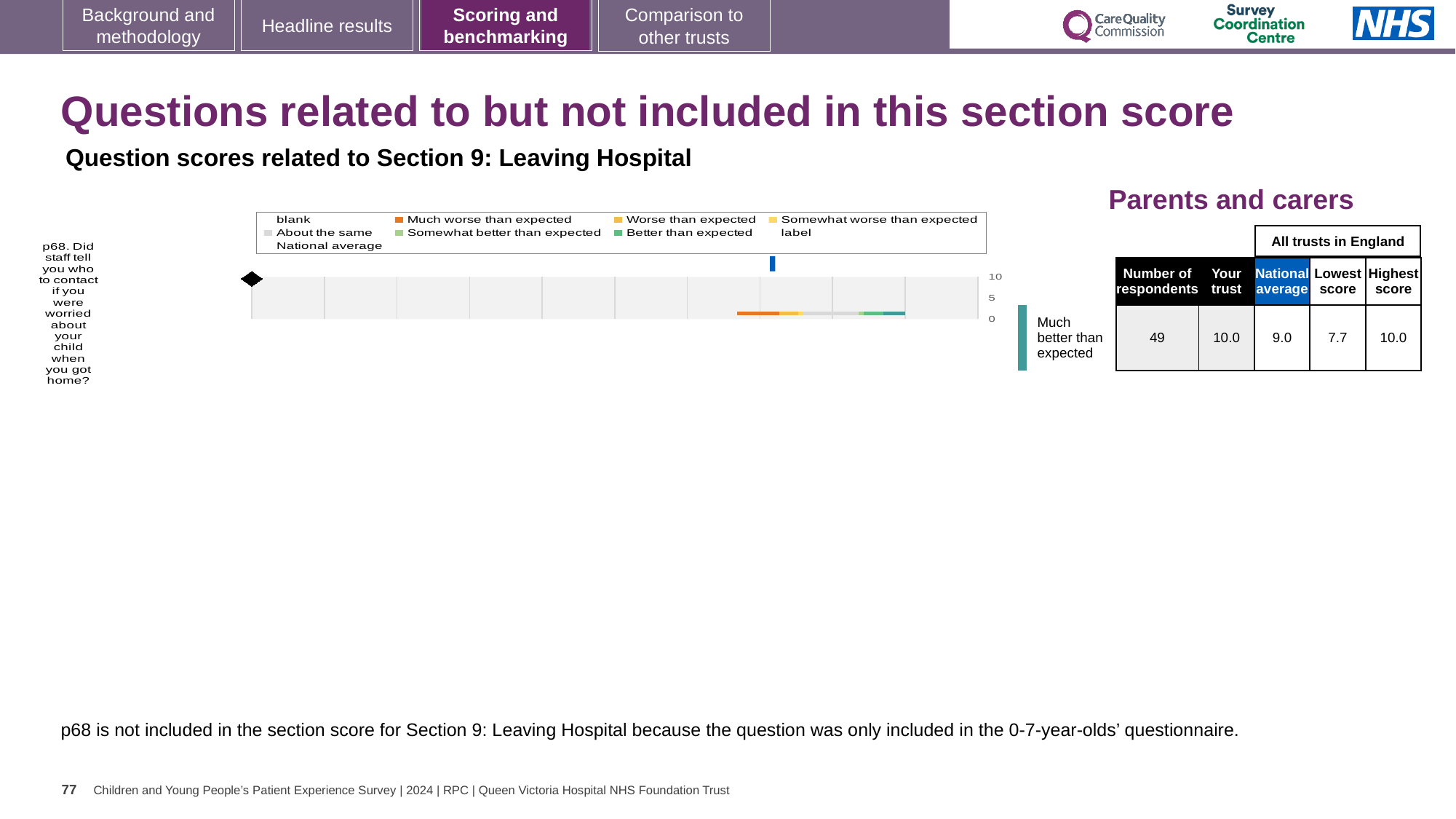
What is the national average score for question p68? 9.0 How many survey questions are plotted on the chart? 1 What is the difference between the highest and lowest scores among all trusts in England for question p68? 2.3 What kind of chart is shown on the slide? bar chart What is the difference between the 'Your trust' score and the national average for question p68? 1.0 What is the lowest score among all trusts in England for question p68? 7.7 Which question is plotted on the chart? p68. Did staff tell you who to contact if you were worried about your child when you got home? What is the highest score among all trusts in England for question p68? 10.0 Which is larger for question p68, the 'Your trust' score or the national average? Your trust What rating label is shown to the right of the chart for question p68? Much better than expected How many respondents answered question p68? 49 What is the 'Your trust' score for question p68? 10.0